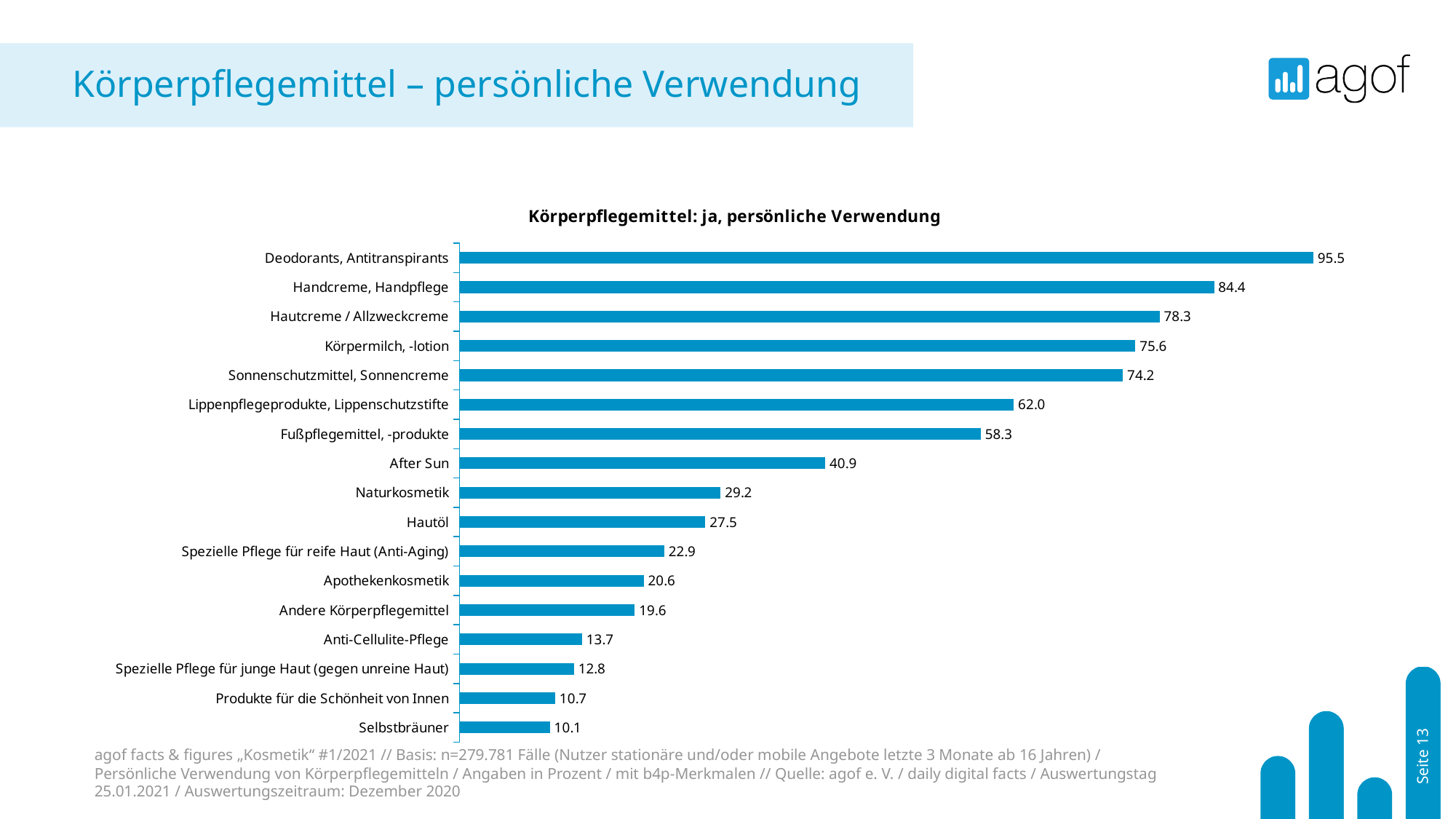
What is the value for Sonnenschutzmittel, Sonnencreme? 74.2 What is the value for After Sun? 40.9 What is the difference between the values for Deodorants, Antitranspirants and Handcreme, Handpflege? 11.1 Which category has the lowest value? Selbstbräuner Which is larger, the value for Naturkosmetik or the value for Anti-Cellulite-Pflege? Naturkosmetik What kind of chart is shown on the slide? Bar chart How many categories are shown in the chart? 17 What is the title of the chart? Körperpflegemittel: ja, persönliche Verwendung What is the difference between the values for Lippenpflegeprodukte, Lippenschutzstifte and Fußpflegemittel, -produkte? 3.7 Which category has the highest value? Deodorants, Antitranspirants What is the value for Apothekenkosmetik? 20.6 What is the value for Handcreme, Handpflege? 84.4